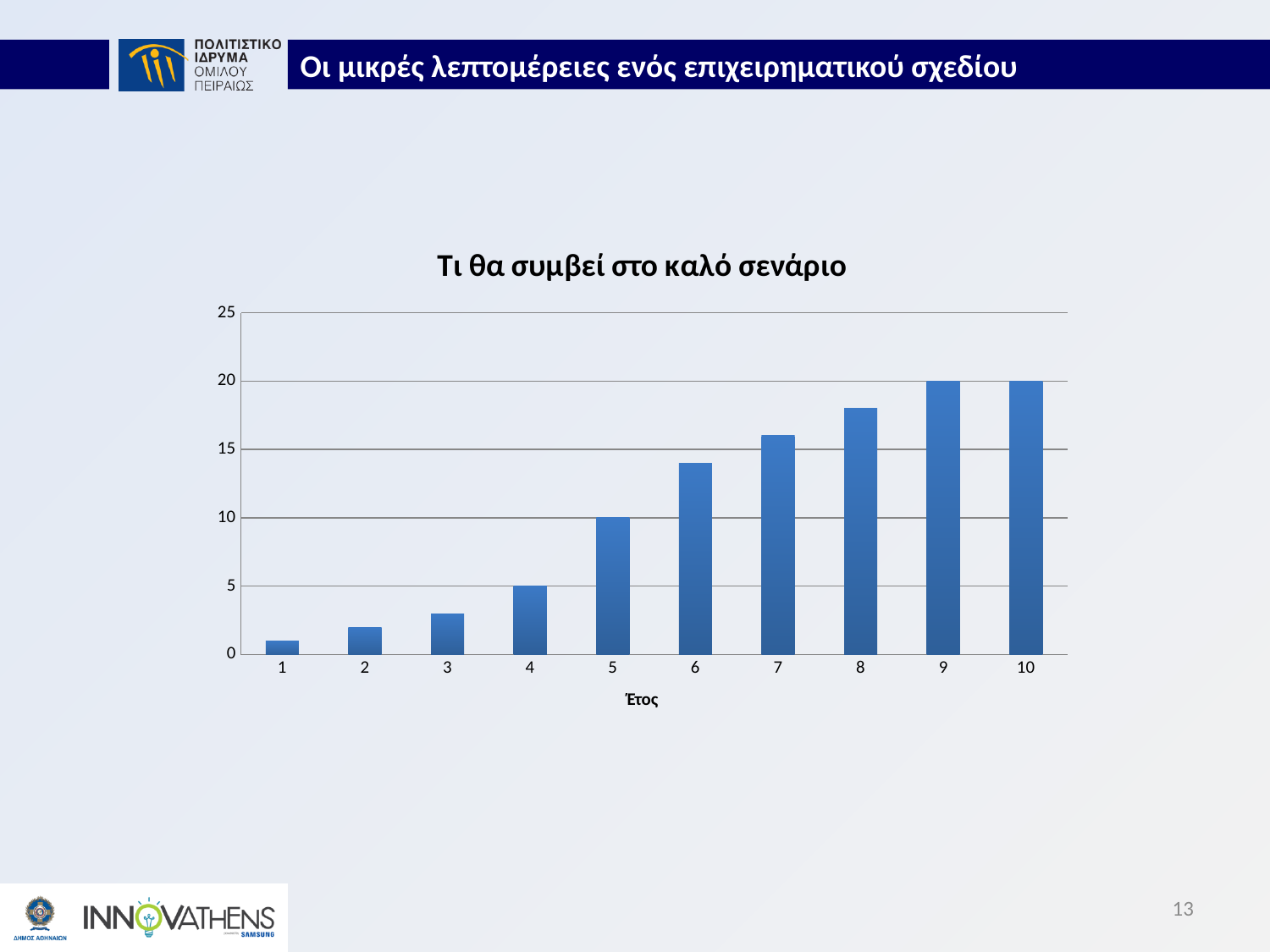
Is the value for year 7 greater or less than 15? greater Which year has the lowest value? 1 How many years (bars) are plotted on the chart? 10 What kind of chart is shown on the slide? bar chart What is the label of the x axis? Έτος Is the value for year 8 greater or less than 20? less What is the value for year 5? 10 What is the value for year 4? 5 What is the difference between the values for year 5 and year 4? 5 Do the values generally rise or fall from year 1 to year 10? rise What is the value for year 10? 20 What is the title of the chart? Τι θα συμβεί στο καλό σενάριο